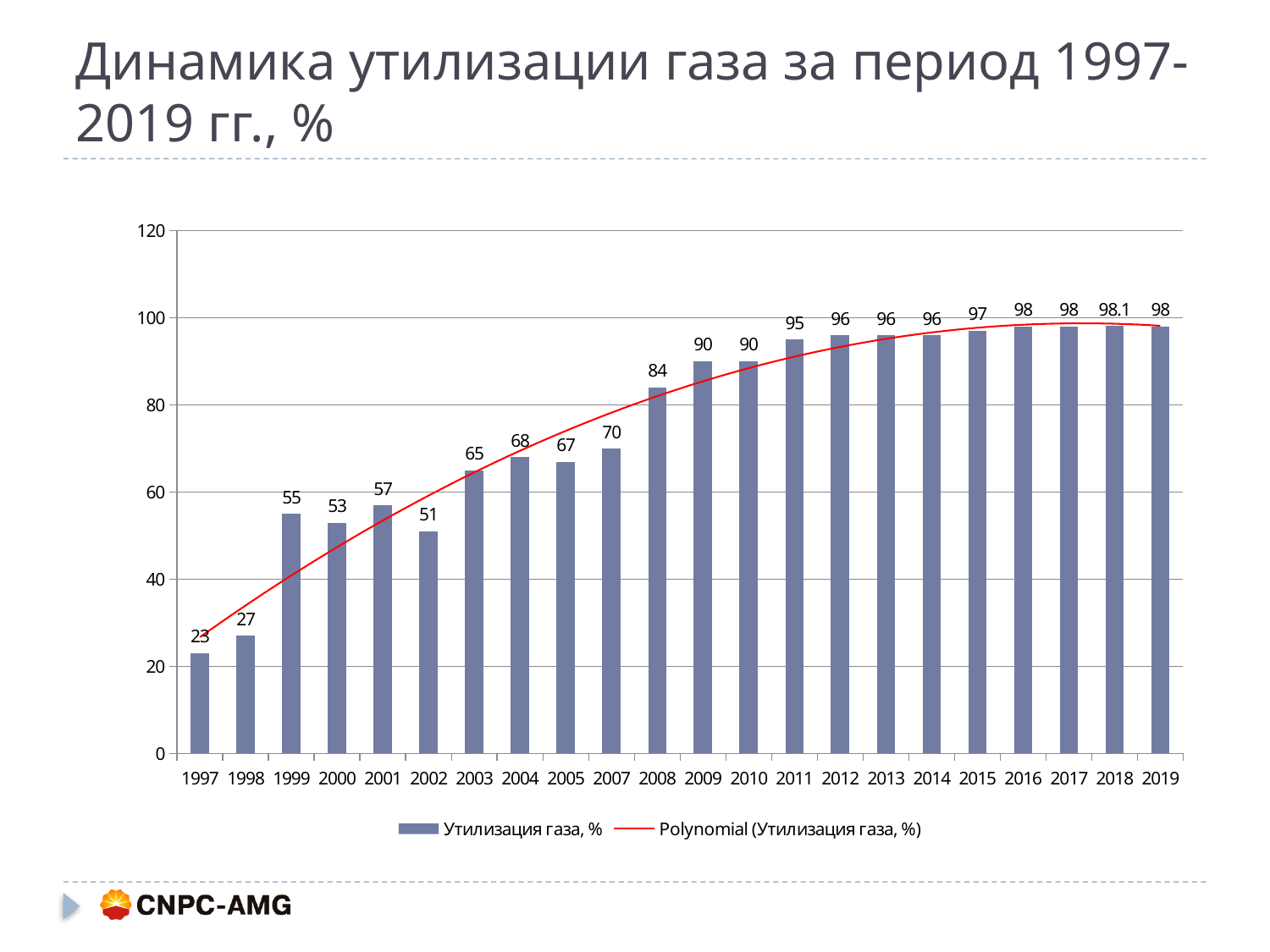
What kind of chart is this? bar chart What is the value for 2002? 51 Is the value for 2011 greater or less than 80? greater What is the difference between the values for 2008 and 2005? 17 How many years are shown on the x axis? 22 What is the value for 1997? 23 What is the difference between the values for 2019 and 1997? 75 Which year has the lowest value? 1997 What is the value for 2008? 84 Which is larger, the value for 2001 or the value for 2002? 2001 How many entries does the legend list? 2 What is the value for 2018? 98.1